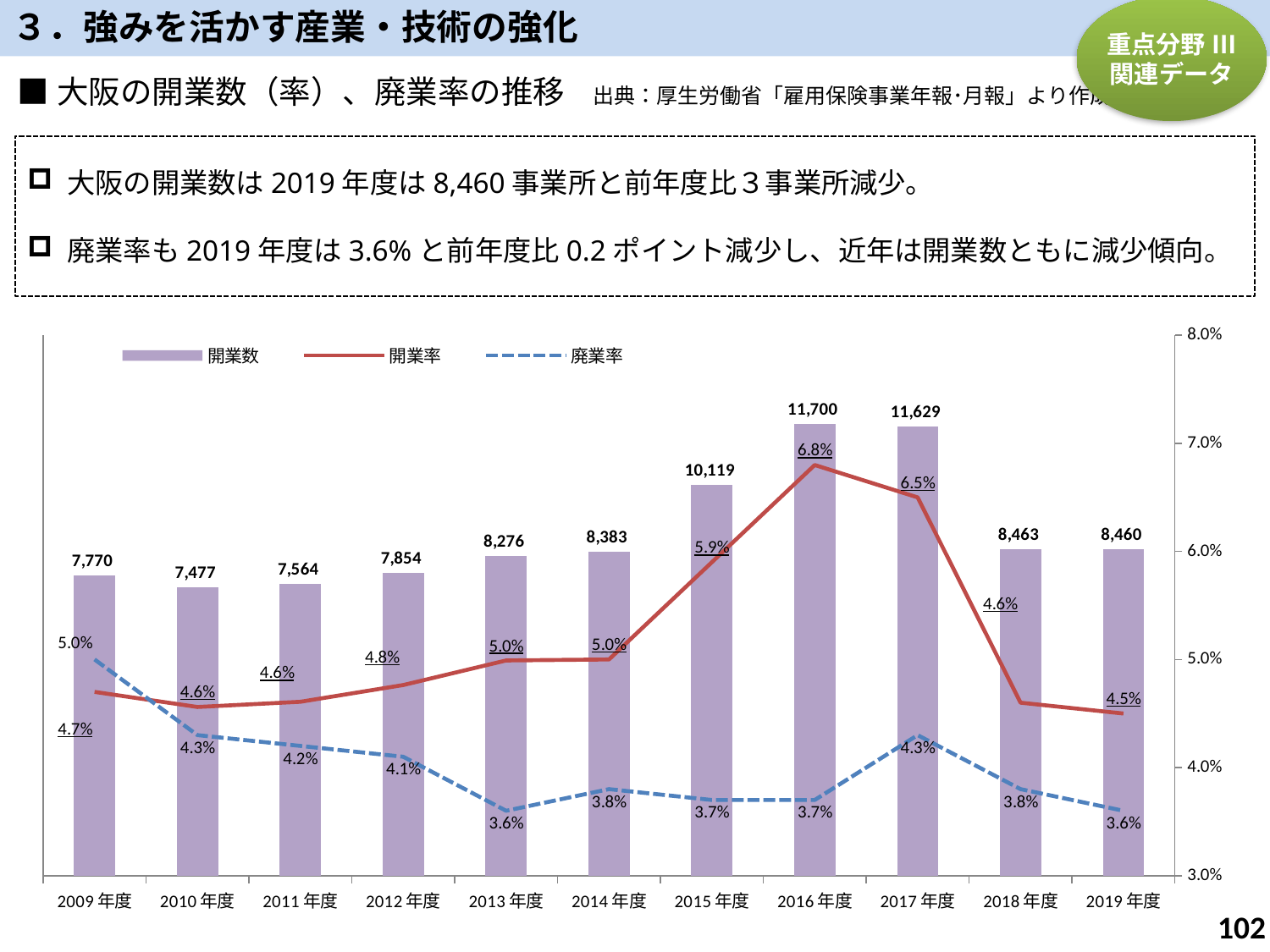
What is the 廃業率 value for 2009年度? 5.0% How many series does the legend list? 3 What is the difference in 開業数 between 2016年度 and 2017年度? 71 What kind of chart is this? Combined bar and line chart How many years are shown on the x axis? 11 What is the 開業数 value for 2016年度? 11,700 Which is larger, the 開業数 for 2018年度 or for 2019年度? 2018年度 Which year has the highest 開業数? 2016年度 What is the 開業率 value for 2017年度? 6.5% Does the 廃業率 rise or fall from 2017年度 to 2019年度? Fall Which series is drawn as a dashed line? 廃業率 Which year has the lowest 開業数? 2010年度